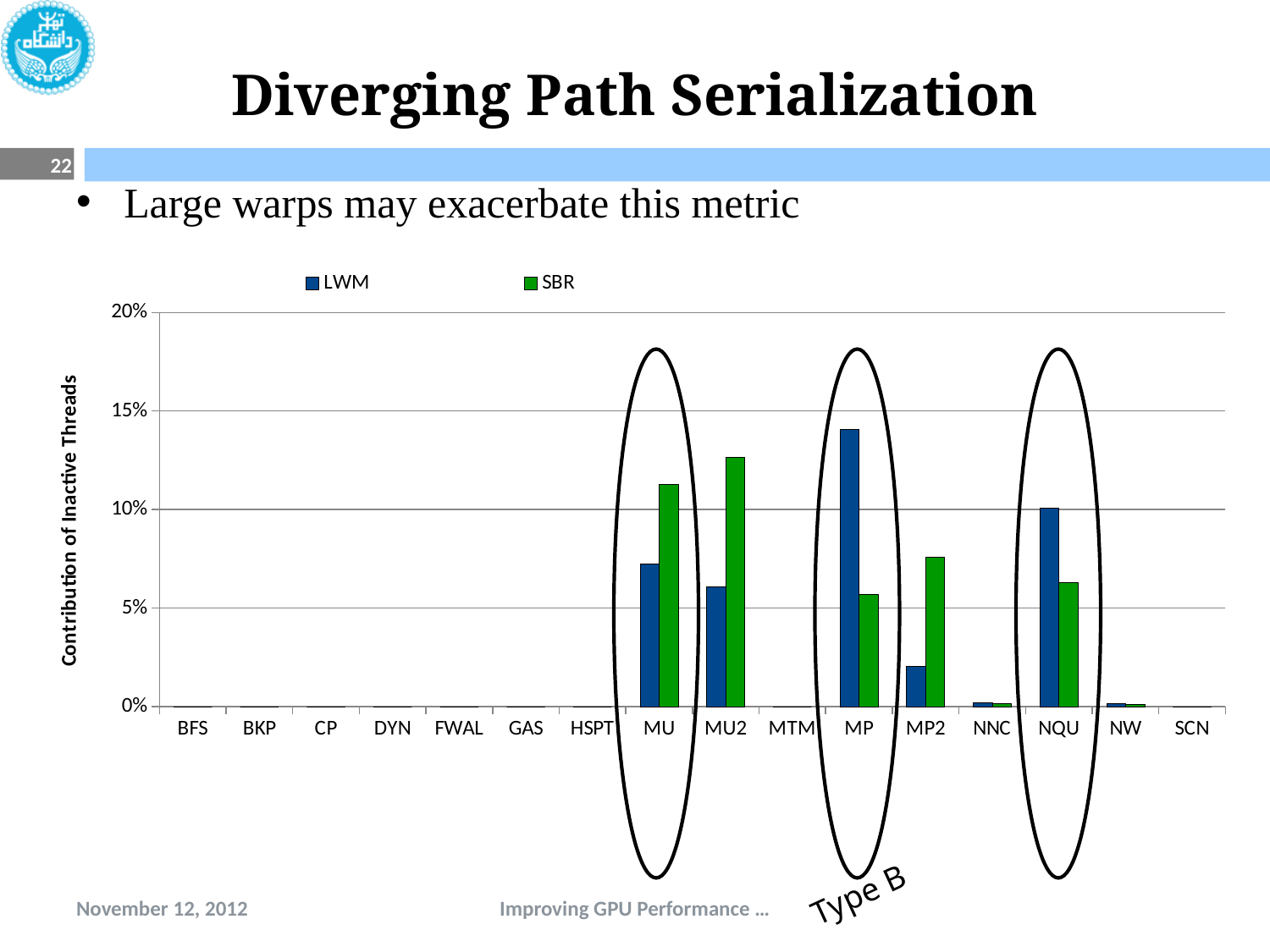
Which colour represents the SBR series? green Is the SBR value for MU2 greater or less than 10%? greater Is the LWM value for MP greater or less than 10%? greater Which category has the highest LWM value? MP How many series does the legend list? 2 Is the LWM value for MP2 greater or less than 5%? less For MU, which series has the larger value, LWM or SBR? SBR How many categories are shown along the x axis? 16 Which category has the highest SBR value? MU2 What is the title of the y axis? Contribution of Inactive Threads What kind of chart is shown on the slide? bar chart For MP, which series has the larger value, LWM or SBR? LWM